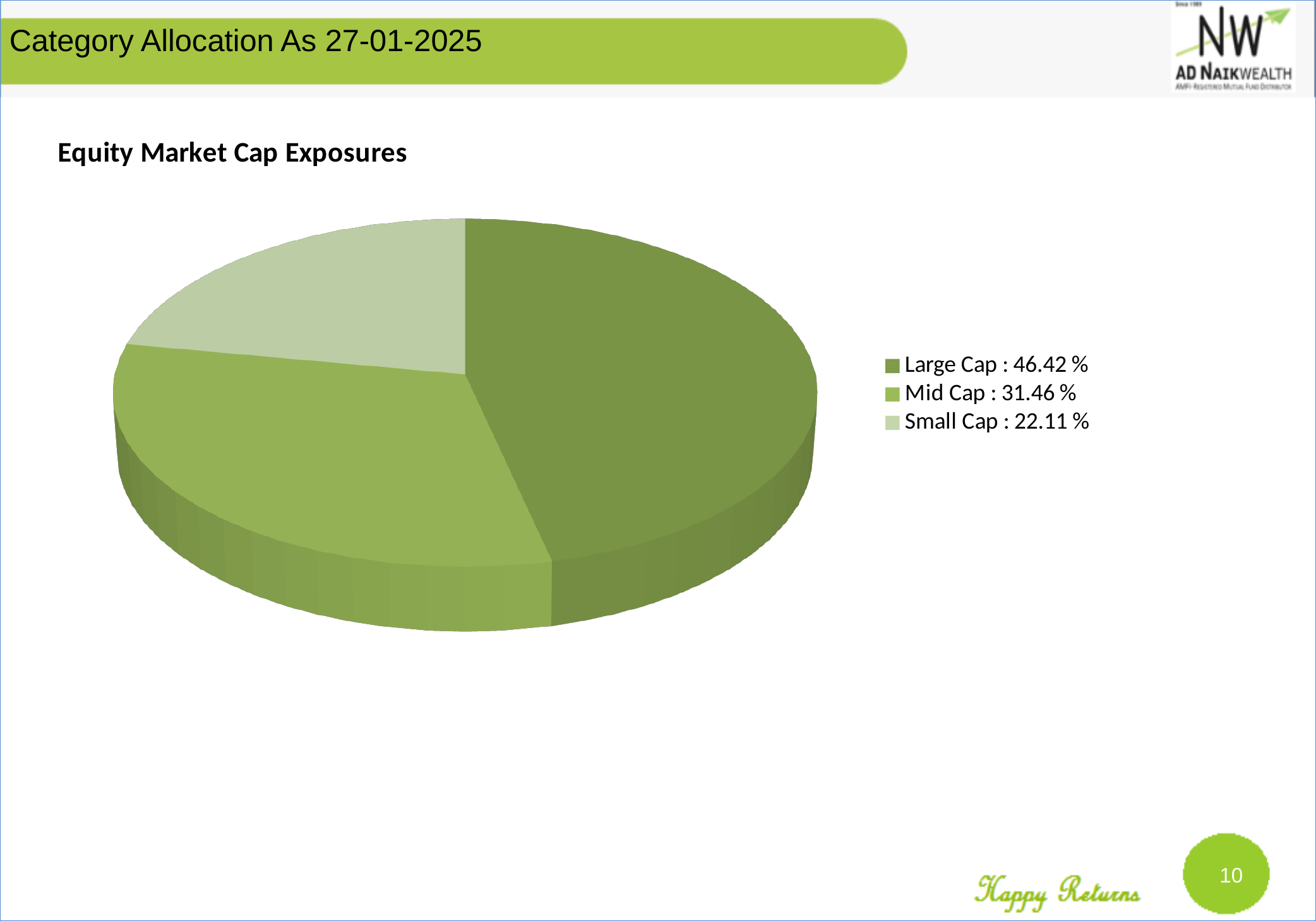
What is the difference between the Large Cap and Mid Cap values? 14.96 % What is the title of the chart? Equity Market Cap Exposures Which category has the largest share of the pie? Large Cap Which category is shown in the lightest green colour? Small Cap What is the value for Small Cap? 22.11 % What is the value for Mid Cap? 31.46 % What is the value for Large Cap? 46.42 % What type of chart is shown on the slide? Pie chart How many categories does the pie chart show? 3 Which category has the smallest share of the pie? Small Cap Which is larger, Mid Cap or Small Cap? Mid Cap What is the difference between the Mid Cap and Small Cap values? 9.35 %